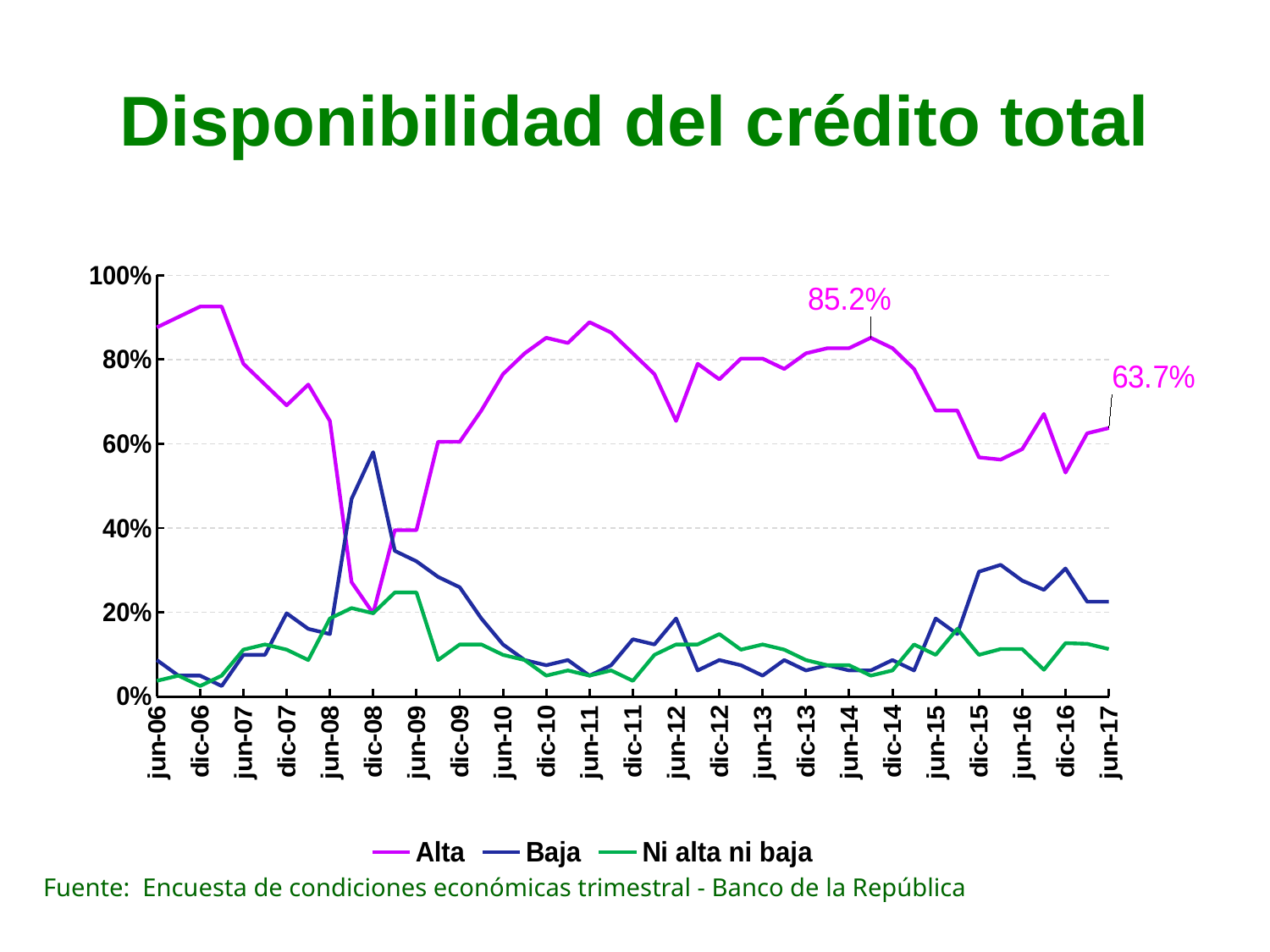
Does the Alta series rise or fall between jun-14 and dic-16? fall At jun-17, which series has the higher value, Alta or Baja? Alta Is the value of the Alta series at dic-08 greater or less than 40%? less What value is labelled on the Alta line near jun-14? 85.2% What colour is the Alta line in the legend? magenta What is the value of the Alta series at jun-17? 63.7% Is the value of the Baja series at dic-08 greater or less than 40%? greater What kind of chart is shown on the slide? line chart How many series does the legend list? 3 What is the title of the chart? Disponibilidad del crédito total What is the difference between the two labelled Alta values, 85.2% and 63.7%? 21.5 percentage points Which series has the lowest value at jun-17? Ni alta ni baja